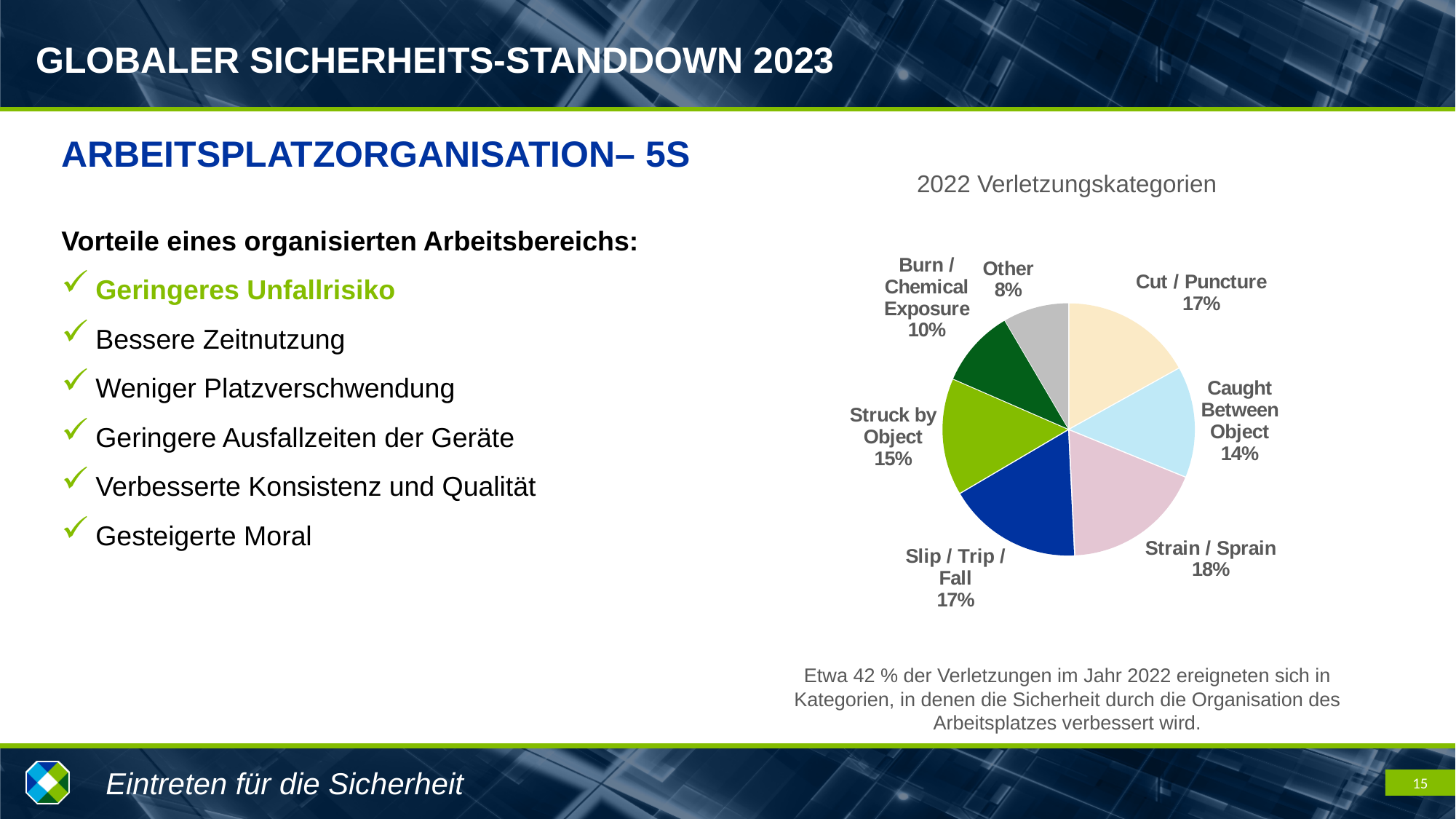
What is the combined share of Slip / Trip / Fall and Struck by Object? 32% What percentage does the Caught Between Object slice represent? 14% Which is larger, the share for Cut / Puncture or the share for Caught Between Object? Cut / Puncture Which category has the smallest share of the pie? Other What colour is the Slip / Trip / Fall slice? dark blue What is the difference in percentage points between Struck by Object and Other? 7 What kind of chart is shown on the slide? pie chart What is the title of the chart? 2022 Verletzungskategorien How many categories does the pie chart show? 7 What share of injuries is attributed to Strain / Sprain? 18% Which category has the largest share of the pie? Strain / Sprain What is the value shown for Burn / Chemical Exposure? 10%